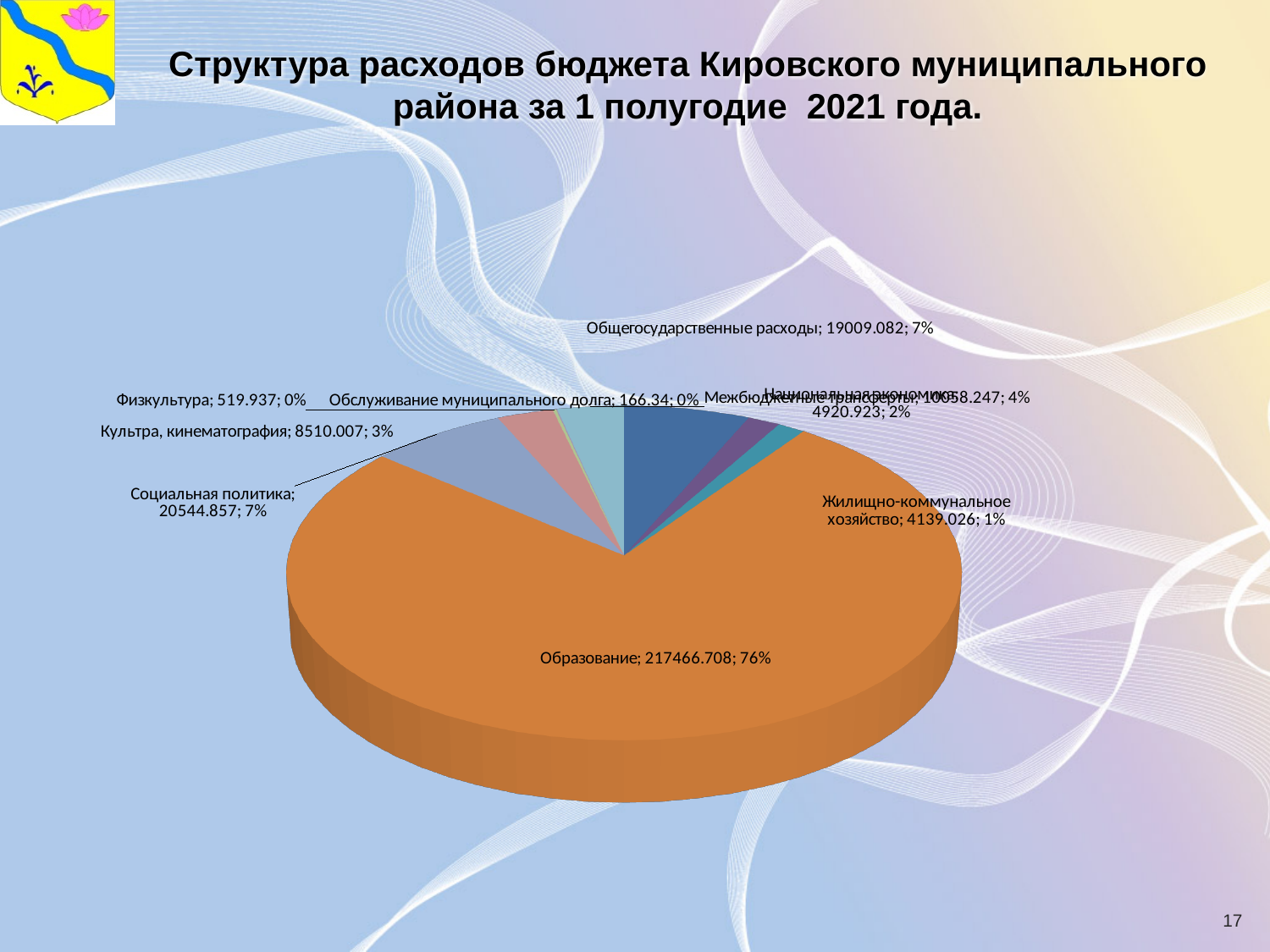
What is the value shown for Социальная политика? 20544.857 Which is larger, the value for Социальная политика or the value for Общегосударственные расходы? Социальная политика What share of the pie does Культра, кинематография take? 3% What share of the pie does Образование take? 76% What is the value shown for Общегосударственные расходы? 19009.082 Which category has the smallest value in the pie chart? Обслуживание муниципального долга What kind of chart is shown on the slide? pie chart What is the value shown for Жилищно-коммунальное хозяйство? 4139.026 Which category has the largest slice of the pie? Образование What is the difference between the values for Социальная политика and Общегосударственные расходы? 1535.775 What is the value shown for Образование? 217466.708 How many categories are shown in the pie chart? 9